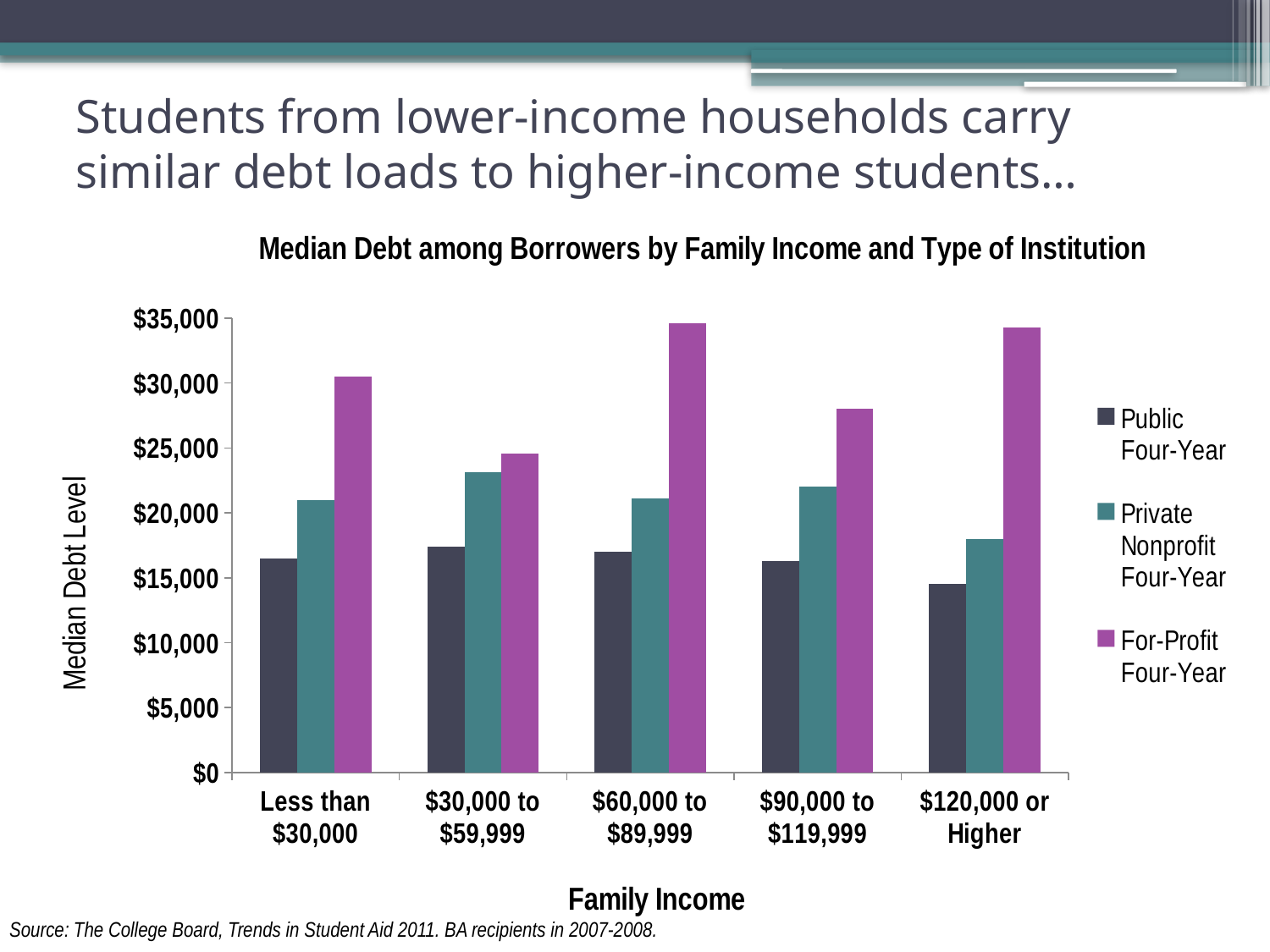
Which family income category has the lowest Private Nonprofit Four-Year median debt? $120,000 or Higher Is the For-Profit Four-Year value for $90,000 to $119,999 greater or less than $30,000? less How many series does the legend list? 3 Is the For-Profit Four-Year value for Less than $30,000 greater or less than $25,000? greater What is the title of the chart? Median Debt among Borrowers by Family Income and Type of Institution Which family income category has the lowest Public Four-Year median debt? $120,000 or Higher How many family income categories are shown on the x axis? 5 What kind of chart is shown on the slide? Bar chart Is the Public Four-Year value for $120,000 or Higher greater or less than $15,000? less What is the label on the vertical axis? Median Debt Level Which family income category has the lowest For-Profit Four-Year median debt? $30,000 to $59,999 In the Less than $30,000 category, which is larger: the Public Four-Year value or the Private Nonprofit Four-Year value? Private Nonprofit Four-Year